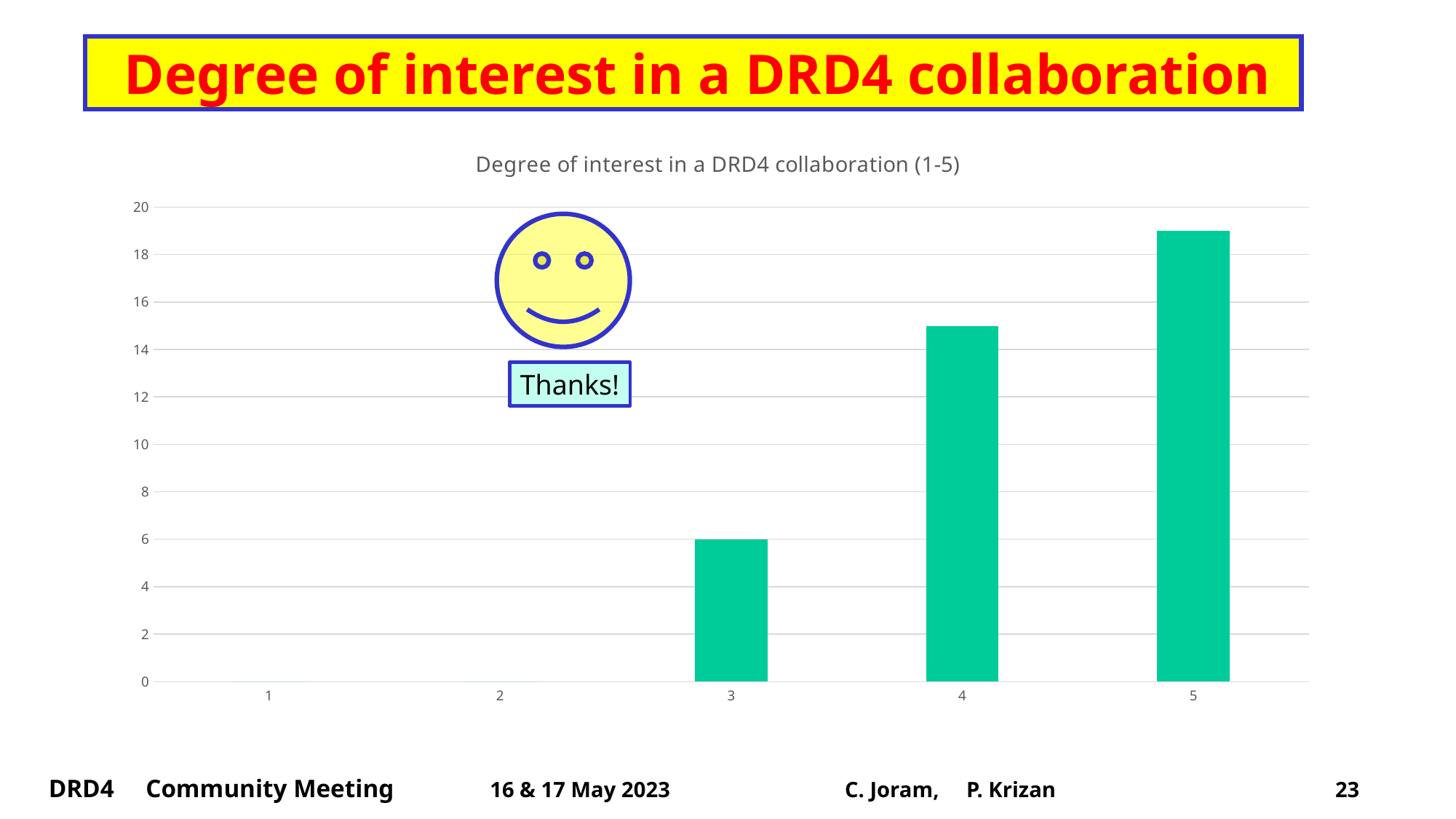
Which category has the highest value? 5 Which is larger, the value for category 4 or the value for category 3? category 4 How many categories are shown on the x axis of the chart? 5 Is the value for category 5 greater or less than 18? greater Is the value for category 5 greater or less than 20? less Do the values rise or fall as the category number increases from 1 to 5? rise Is the value for category 4 greater or less than 14? greater What is the value for category 1? 0 What is the value for category 3? 6 What kind of chart is shown on the slide? bar chart What colour are the bars in the chart? green What is the title of the chart? Degree of interest in a DRD4 collaboration (1-5)